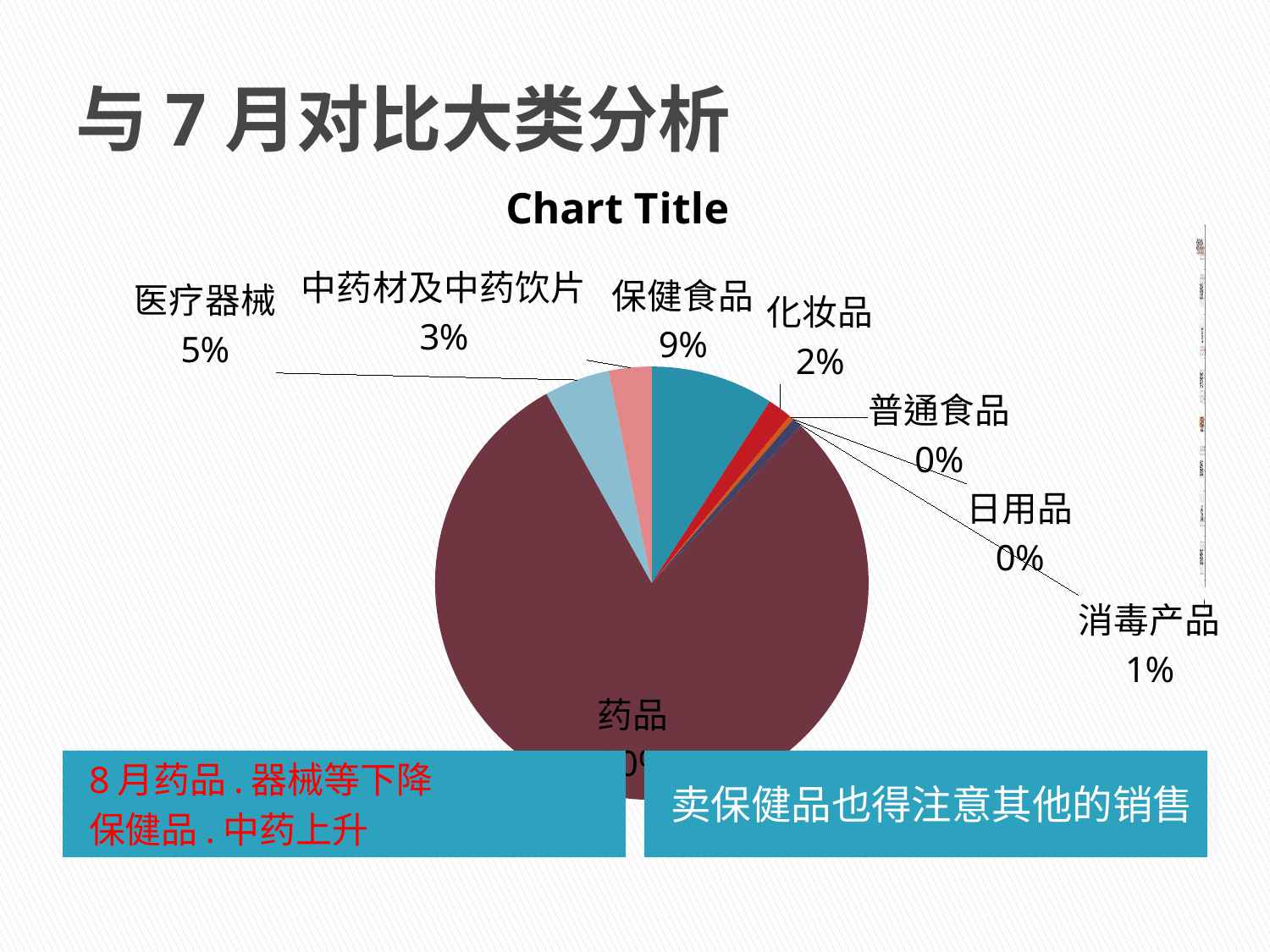
What type of chart is shown on the slide? pie chart What share of the pie does 医疗器械 have? 5% What is the title of the chart? Chart Title What is the difference between the shares of 保健食品 and 中药材及中药饮片? 6% What share of the pie does 中药材及中药饮片 have? 3% Which is larger, the share for 保健食品 or the share for 医疗器械? 保健食品 What share of the pie does 化妆品 have? 2% Which category has the largest slice of the pie? 药品 How many categories are shown in the pie chart? 8